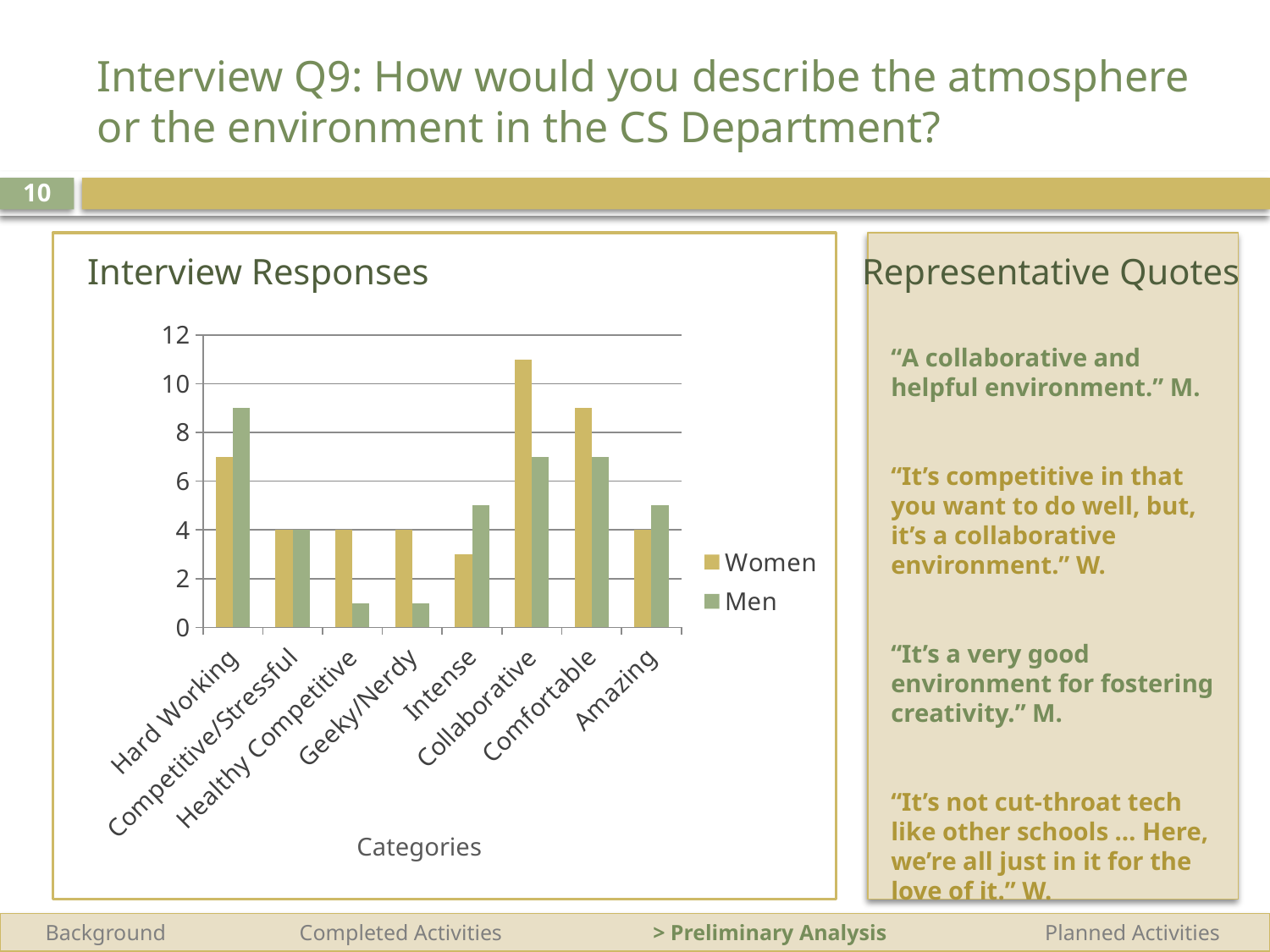
Is the value for Men in the Healthy Competitive category greater or less than 2? less In the Collaborative category, which series has the larger value, Women or Men? Women What is the value for Women in the Competitive/Stressful category? 4 How many categories are shown on the x axis of the Interview Responses chart? 8 What type of chart is shown under the title "Interview Responses"? bar chart Which category has the highest Women value? Collaborative Which category has the highest Men value? Hard Working How many series does the legend of the Interview Responses chart list? 2 What is the value for Men in the Competitive/Stressful category? 4 In the Hard Working category, which series has the larger value, Women or Men? Men What is the value for Women in the Geeky/Nerdy category? 4 What is the x-axis title of the Interview Responses chart? Categories